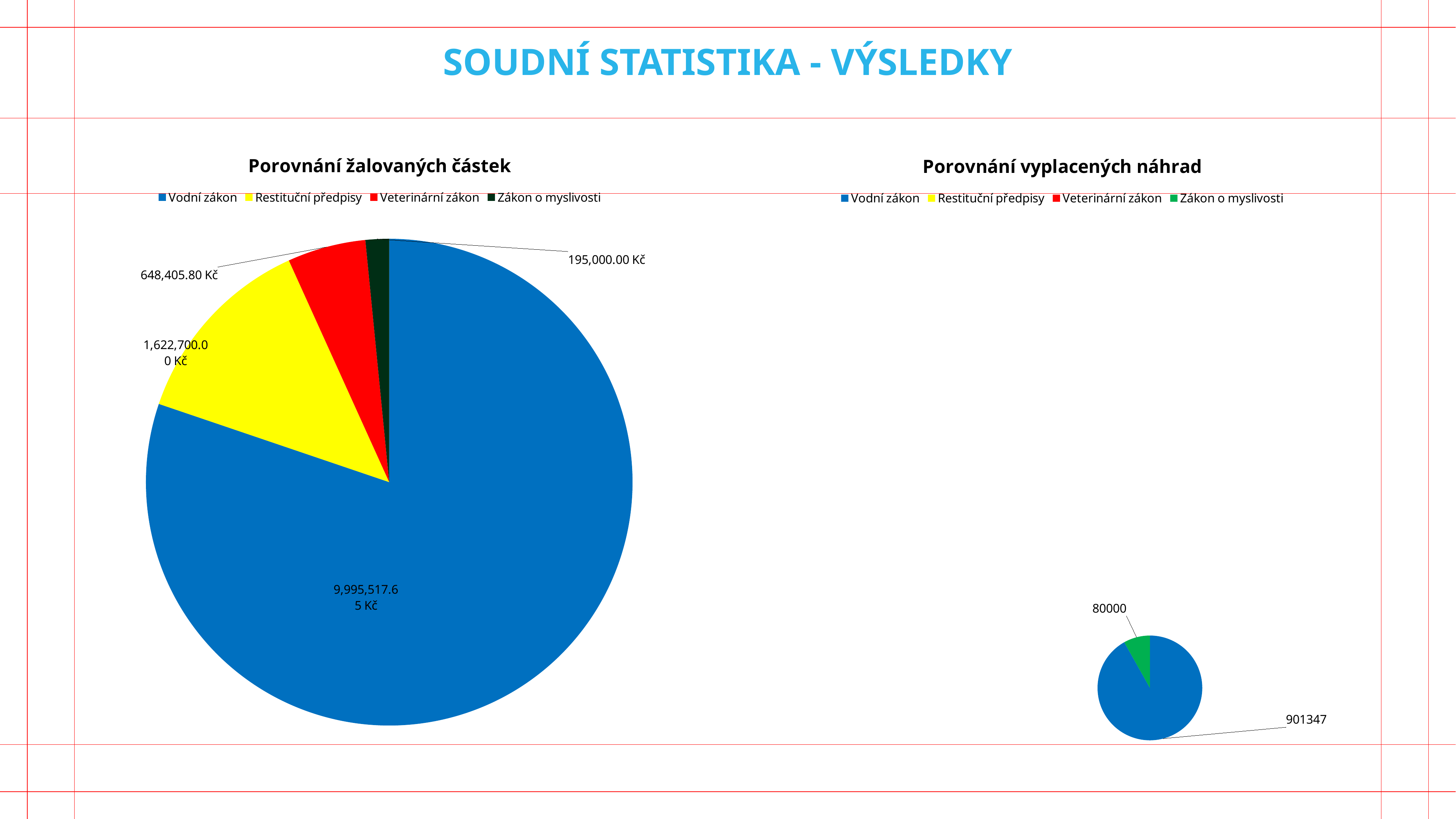
How many entries does the legend of the "Porovnání žalovaných částek" chart list? 4 What type of chart is "Porovnání žalovaných částek"? pie chart In the "Porovnání vyplacených náhrad" chart, what is the difference between Vodní zákon and Zákon o myslivosti? 821347 In the "Porovnání vyplacených náhrad" chart, what is the value for Vodní zákon? 901347 In the "Porovnání žalovaných částek" chart, what is the difference between Restituční předpisy and Veterinární zákon? 974,294.20 Kč In the "Porovnání žalovaných částek" chart, what is the value for Vodní zákon? 9,995,517.65 Kč In the "Porovnání žalovaných částek" chart, which category has the smallest slice? Zákon o myslivosti In the "Porovnání žalovaných částek" chart, which category has the largest slice? Vodní zákon In the "Porovnání vyplacených náhrad" chart, which is larger, Vodní zákon or Zákon o myslivosti? Vodní zákon In the "Porovnání vyplacených náhrad" chart, what is the value for Zákon o myslivosti? 80000 In the "Porovnání žalovaných částek" chart, what is the value for Veterinární zákon? 648,405.80 Kč In the "Porovnání žalovaných částek" chart, what is the value for Restituční předpisy? 1,622,700.00 Kč